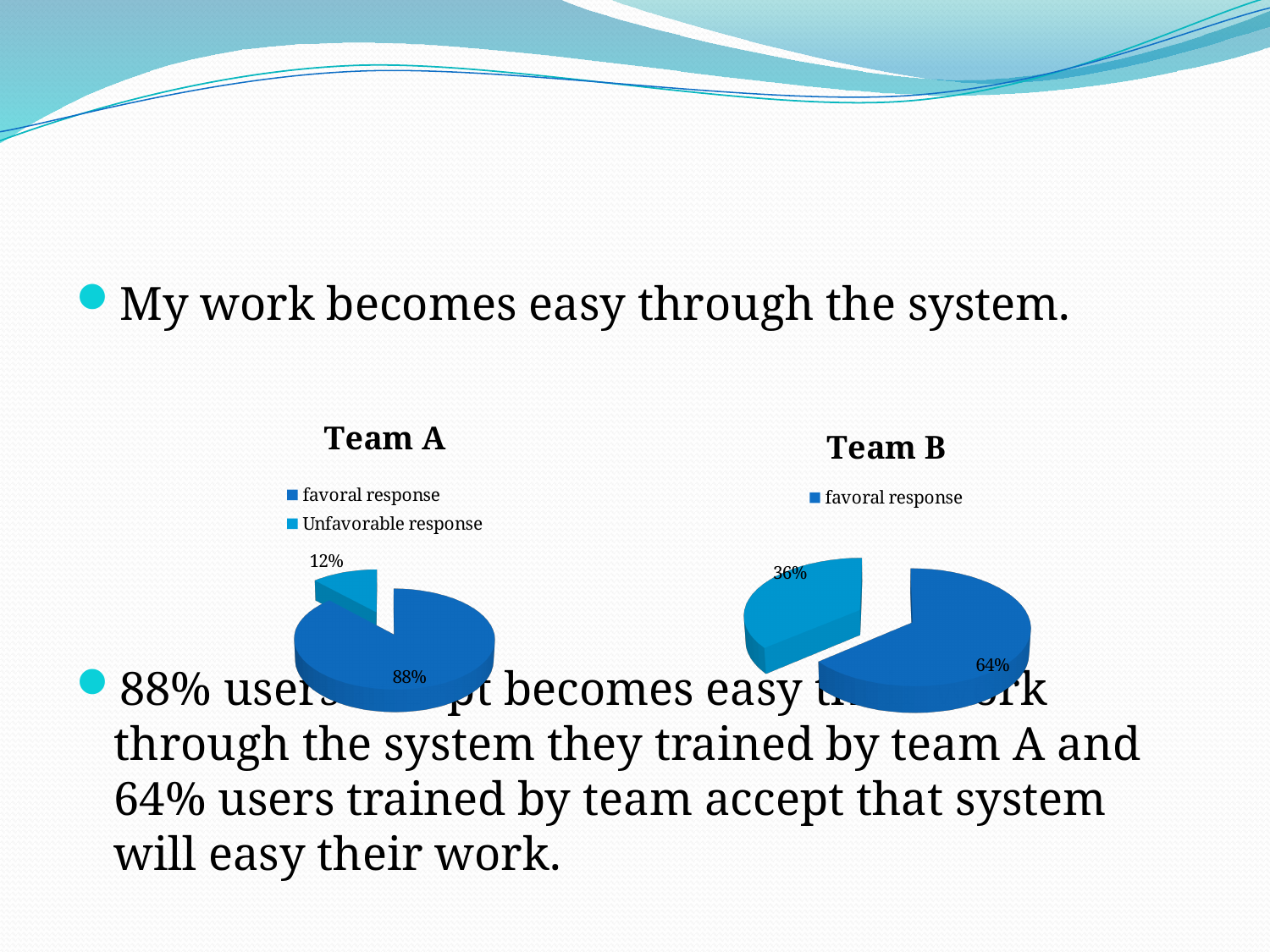
In the Team A chart, what percentage is the Unfavorable response slice? 12% In the Team A chart, which slice is the largest? favoral response How many slices does the Team B chart have? 2 Which chart shows a larger favoral response slice, Team A or Team B? Team A In the Team A chart, what percentage is the favoral response slice? 88% In the Team B chart, what percentage is the favoral response slice? 64% What is the title of the chart on the right side of the slide? Team B In the Team A chart, what is the difference between the favoral response and Unfavorable response slices? 76% What kind of chart is the Team A chart? pie chart How many entries does the legend of the Team B chart list? 1 How many entries does the legend of the Team A chart list? 2 In the Team A chart, which slice is the smallest? Unfavorable response